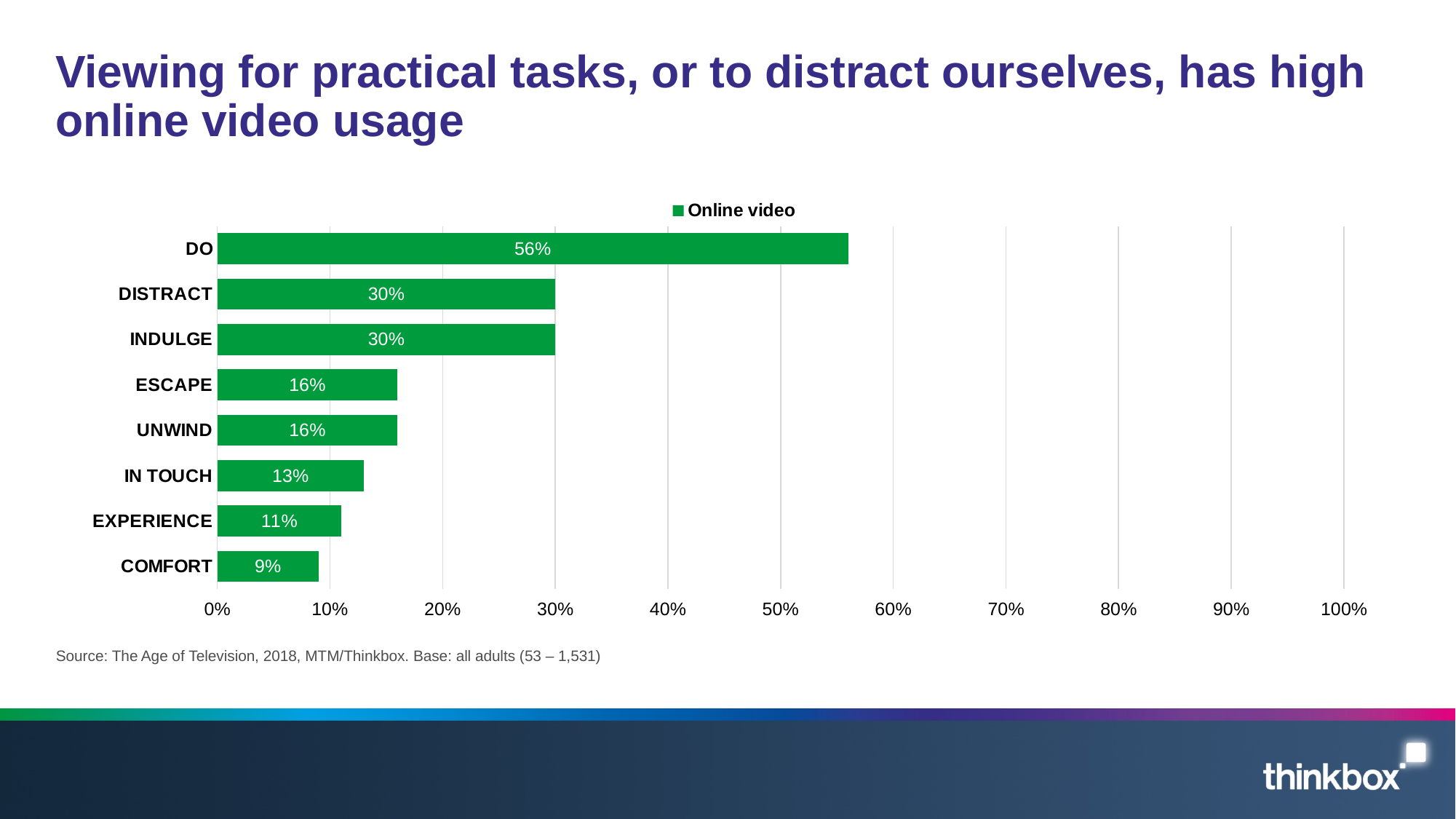
What is the Online video value for IN TOUCH? 13% Which category has the lowest Online video value? COMFORT What is the Online video value for COMFORT? 9% What kind of chart is shown on the slide? Bar chart What is the difference between the Online video values for DO and DISTRACT? 26% Which has a larger Online video value, INDULGE or UNWIND? INDULGE Is the Online video value for DO greater or less than 50%? greater Which category has the highest Online video value? DO How many categories are shown in the chart? 8 What is the Online video value for DO? 56% How many series does the legend list? 1 What is the difference between the Online video values for ESCAPE and EXPERIENCE? 5%